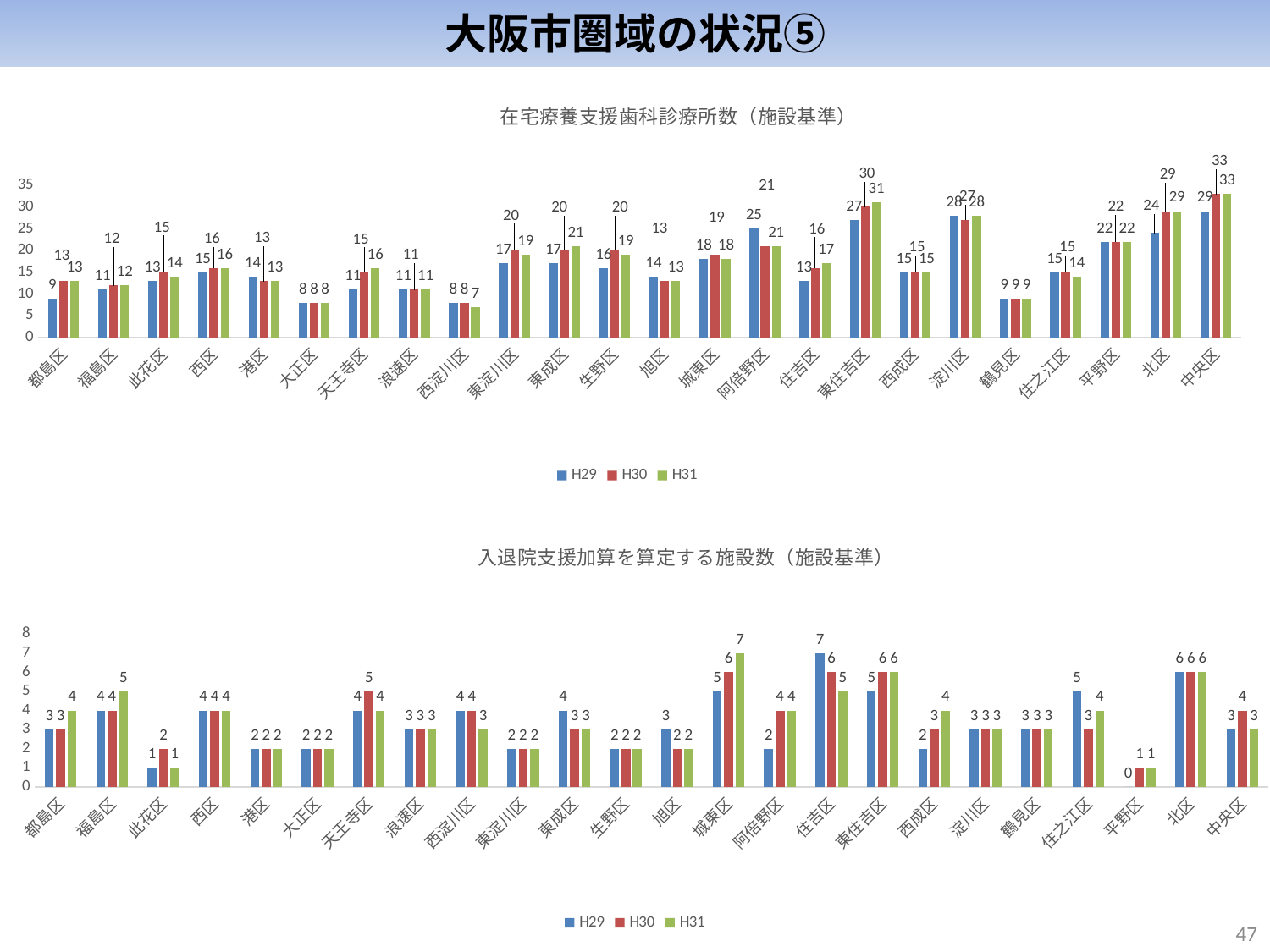
In the top chart (在宅療養支援歯科診療所数), how many series does the legend list? 3 What kind of chart is the bottom chart (入退院支援加算を算定する施設数)? bar chart In the bottom chart (入退院支援加算を算定する施設数), what is the H31 value for 城東区? 7 In the top chart (在宅療養支援歯科診療所数), what is the difference between the H31 and H29 values for 北区? 5 In the bottom chart (入退院支援加算を算定する施設数), what is the difference between the H31 and H29 values for 西成区? 2 In the top chart (在宅療養支援歯科診療所数), how many districts are shown on the x axis? 24 In the top chart (在宅療養支援歯科診療所数), what is the H29 value for 阿倍野区? 25 In the top chart (在宅療養支援歯科診療所数), which district has the highest H31 value? 中央区 In the bottom chart (入退院支援加算を算定する施設数), do the values for 住吉区 rise or fall from H29 to H31? fall In the bottom chart (入退院支援加算を算定する施設数), what is the H29 value for 平野区? 0 In the top chart (在宅療養支援歯科診療所数), which is larger: the H30 value for 東住吉区 or the H30 value for 淀川区? 東住吉区 In the top chart (在宅療養支援歯科診療所数), what is the H31 value for 中央区? 33